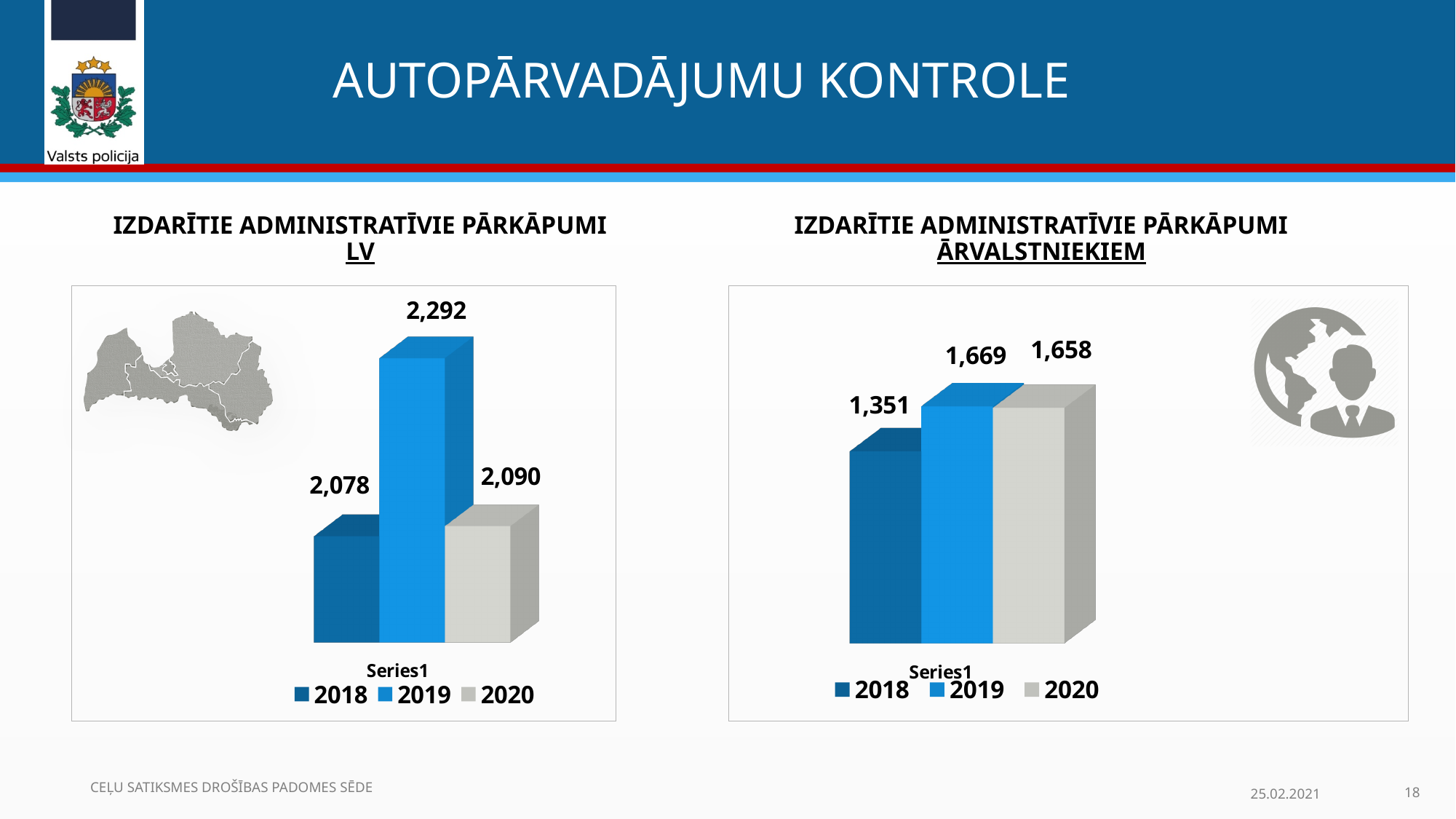
What kind of chart is the left chart (IZDARĪTIE ADMINISTRATĪVIE PĀRKĀPUMI LV)? Bar chart In the left chart (IZDARĪTIE ADMINISTRATĪVIE PĀRKĀPUMI LV), what is the value for 2019? 2,292 In the right chart (IZDARĪTIE ADMINISTRATĪVIE PĀRKĀPUMI ĀRVALSTNIEKIEM), what is the value for 2020? 1,658 In the left chart (IZDARĪTIE ADMINISTRATĪVIE PĀRKĀPUMI LV), what is the difference between the 2019 and 2018 values? 214 In the left chart (IZDARĪTIE ADMINISTRATĪVIE PĀRKĀPUMI LV), which year has the highest value? 2019 In the right chart (IZDARĪTIE ADMINISTRATĪVIE PĀRKĀPUMI ĀRVALSTNIEKIEM), which year has the lowest value? 2018 In the left chart (IZDARĪTIE ADMINISTRATĪVIE PĀRKĀPUMI LV), what is the value for 2018? 2,078 In the right chart (IZDARĪTIE ADMINISTRATĪVIE PĀRKĀPUMI ĀRVALSTNIEKIEM), what is the difference between the 2019 and 2018 values? 318 In the left chart (IZDARĪTIE ADMINISTRATĪVIE PĀRKĀPUMI LV), which colour represents 2020 in the legend? Grey In the left chart (IZDARĪTIE ADMINISTRATĪVIE PĀRKĀPUMI LV), which is larger, the value for 2018 or the value for 2020? 2020 In the right chart (IZDARĪTIE ADMINISTRATĪVIE PĀRKĀPUMI ĀRVALSTNIEKIEM), what is the value for 2018? 1,351 How many series does the legend of the right chart (IZDARĪTIE ADMINISTRATĪVIE PĀRKĀPUMI ĀRVALSTNIEKIEM) list? 3